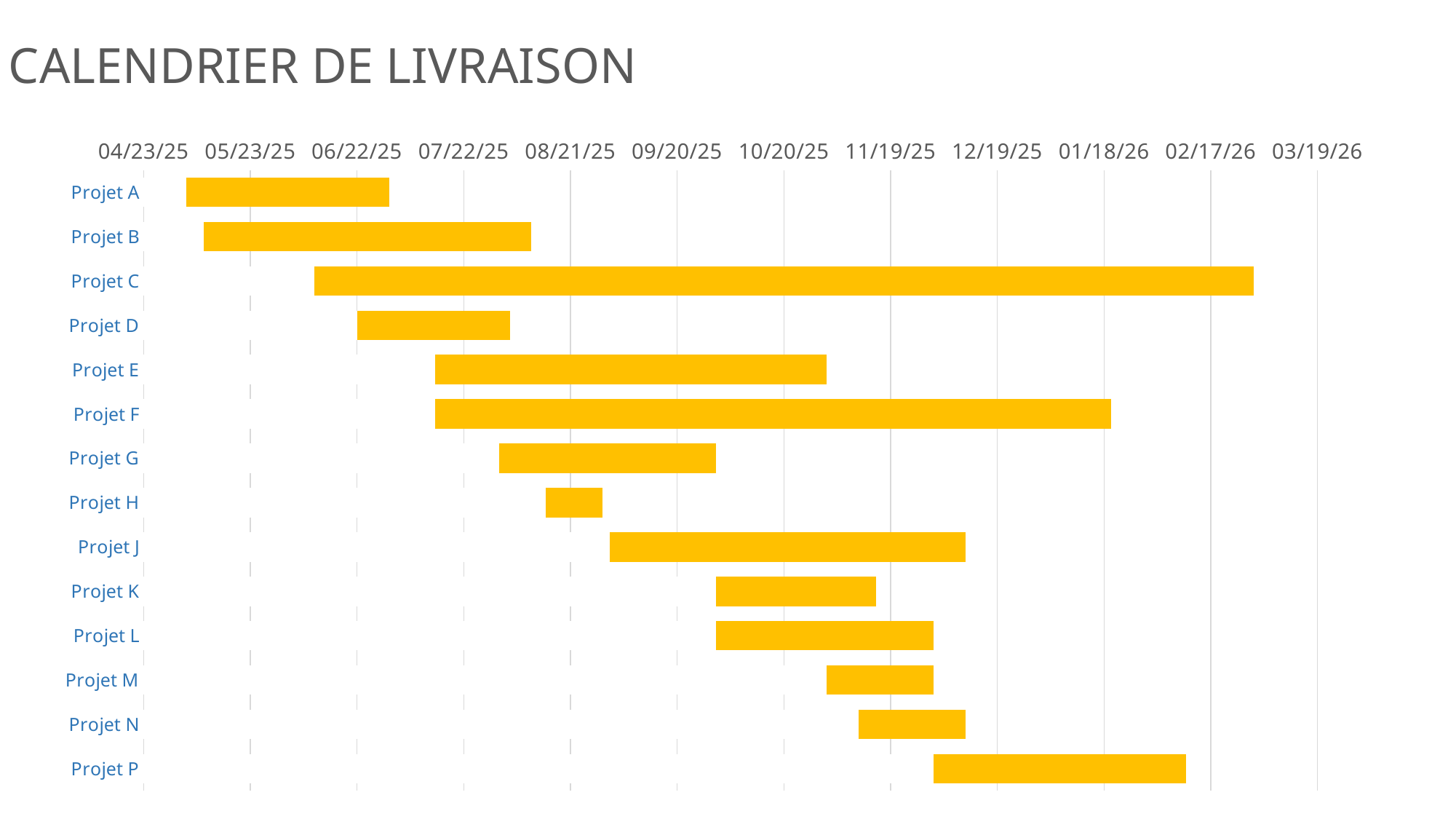
Does the bar for Projet H start before or after 07/22/25? after Does the bar for Projet C end before or after 02/17/26? after Does the bar for Projet A end before or after 06/22/25? after What is the title of the chart? CALENDRIER DE LIVRAISON Which project has the longest bar on the chart? Projet C Which project has the shortest bar on the chart? Projet H How many projects are listed on the chart? 14 Which bar is longer, Projet B or Projet A? Projet B What kind of chart is shown on the slide? Bar chart (Gantt chart) Which bar is longer, Projet F or Projet E? Projet F Which project starts earliest on the timeline? Projet A